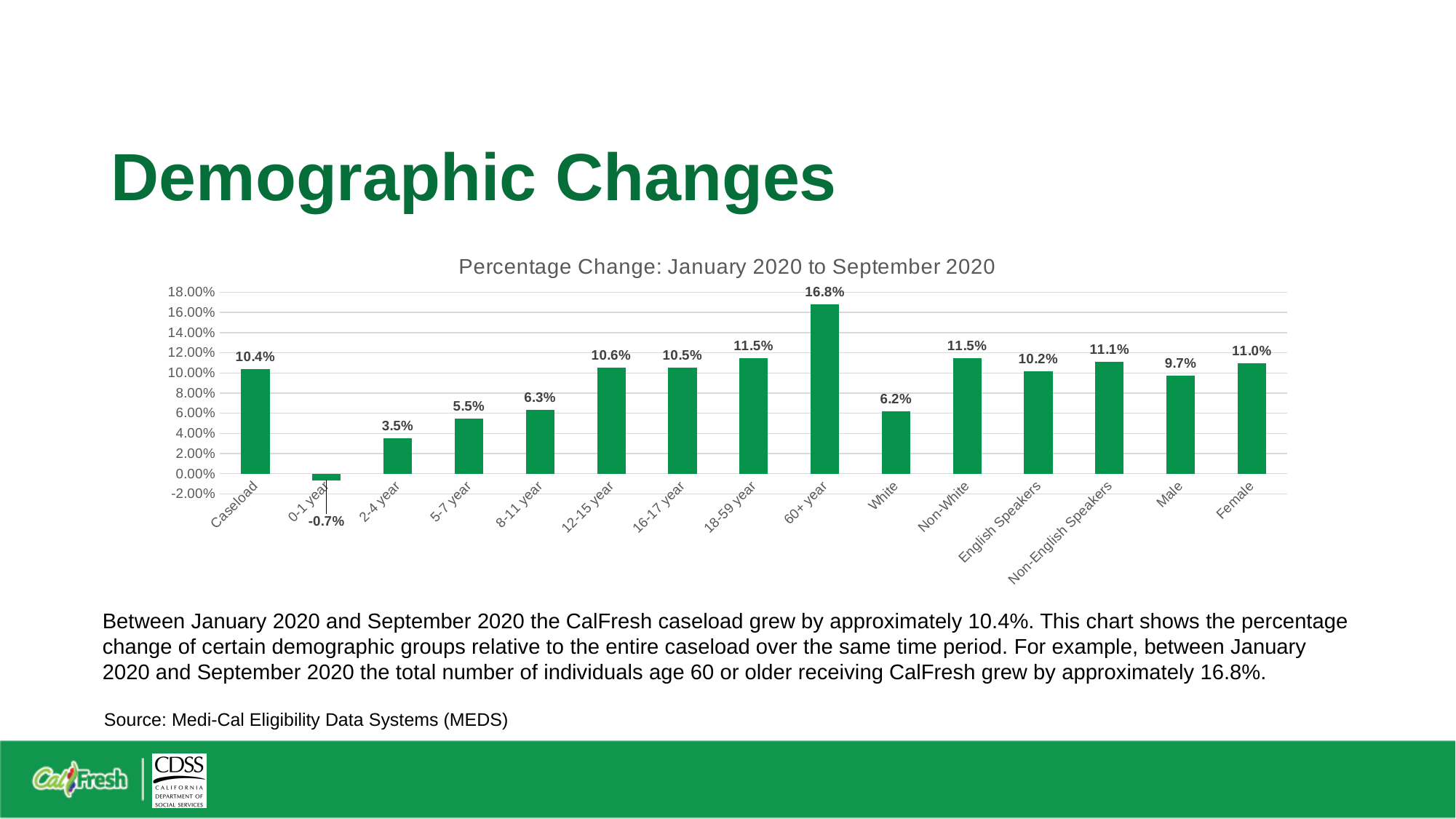
How many categories are shown on the x axis? 15 What is the title of the chart? Percentage Change: January 2020 to September 2020 What is the difference between the percentage change for Female and Male? 1.3% Which category has the highest percentage change? 60+ year Is the value for 8-11 year greater or less than 8.00%? less What kind of chart is shown on the slide? Bar chart What is the percentage change for the 0-1 year group? -0.7% Which has a larger percentage change, White or Non-White? Non-White Which category has the lowest percentage change? 0-1 year What is the percentage change for the 60+ year group? 16.8% What is the difference between the percentage change for 60+ year and Caseload? 6.4% What is the percentage change for Non-English Speakers? 11.1%